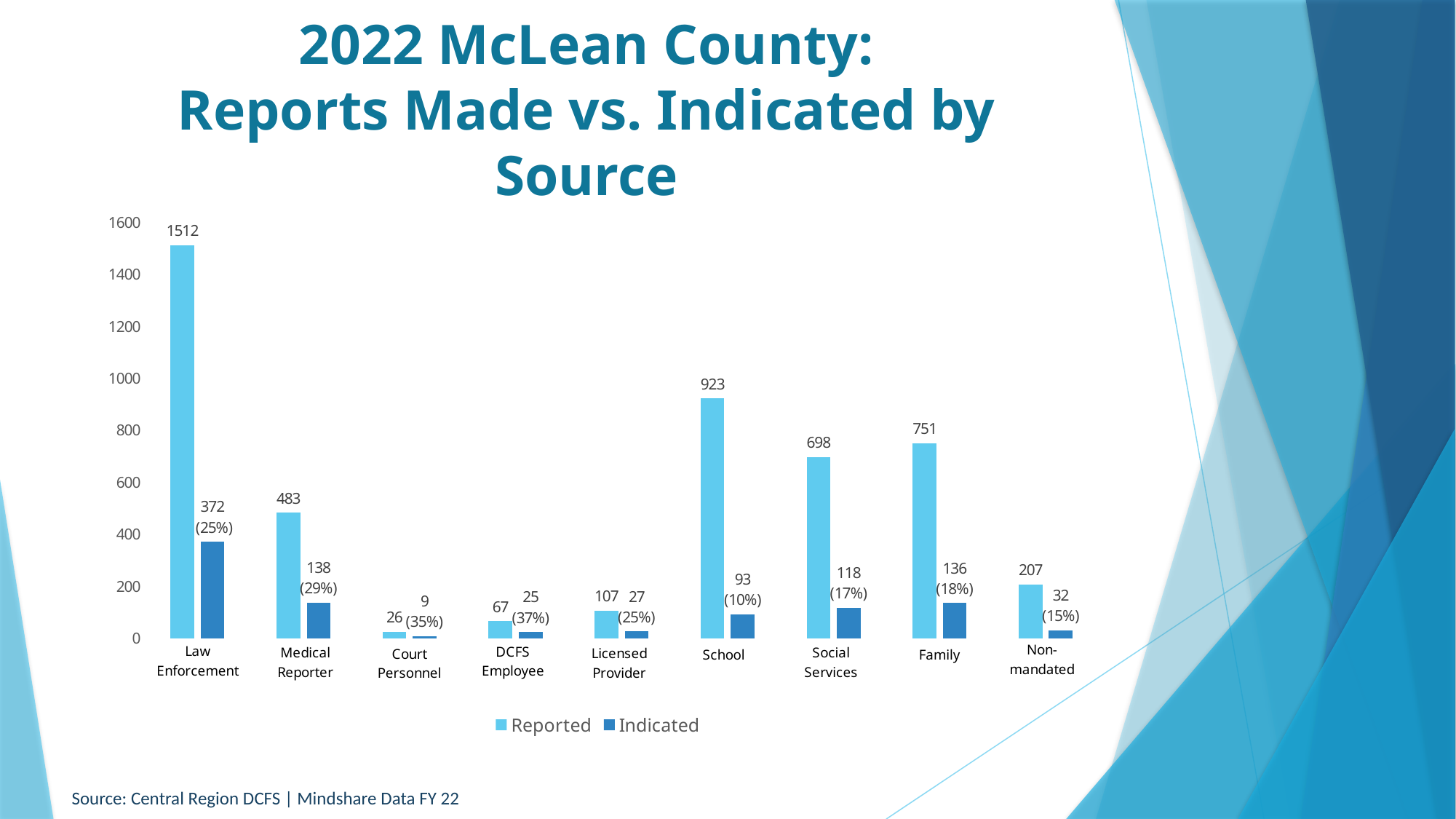
How many series does the legend list? 2 How many source categories are shown on the x axis? 9 How many reports from School were indicated? 93 What is the difference between reported and indicated cases for Family? 615 Which has more reported cases, School or Social Services? School What kind of chart is shown on the slide? Bar chart What is the data source cited at the bottom of the slide? Central Region DCFS | Mindshare Data FY 22 How many reports were made by Law Enforcement? 1512 Which source has the lowest number of indicated reports? Court Personnel What is the total of reported and indicated cases for Non-mandated? 239 What percentage of Medical Reporter reports were indicated? 29% Which source has the highest number of reported cases? Law Enforcement